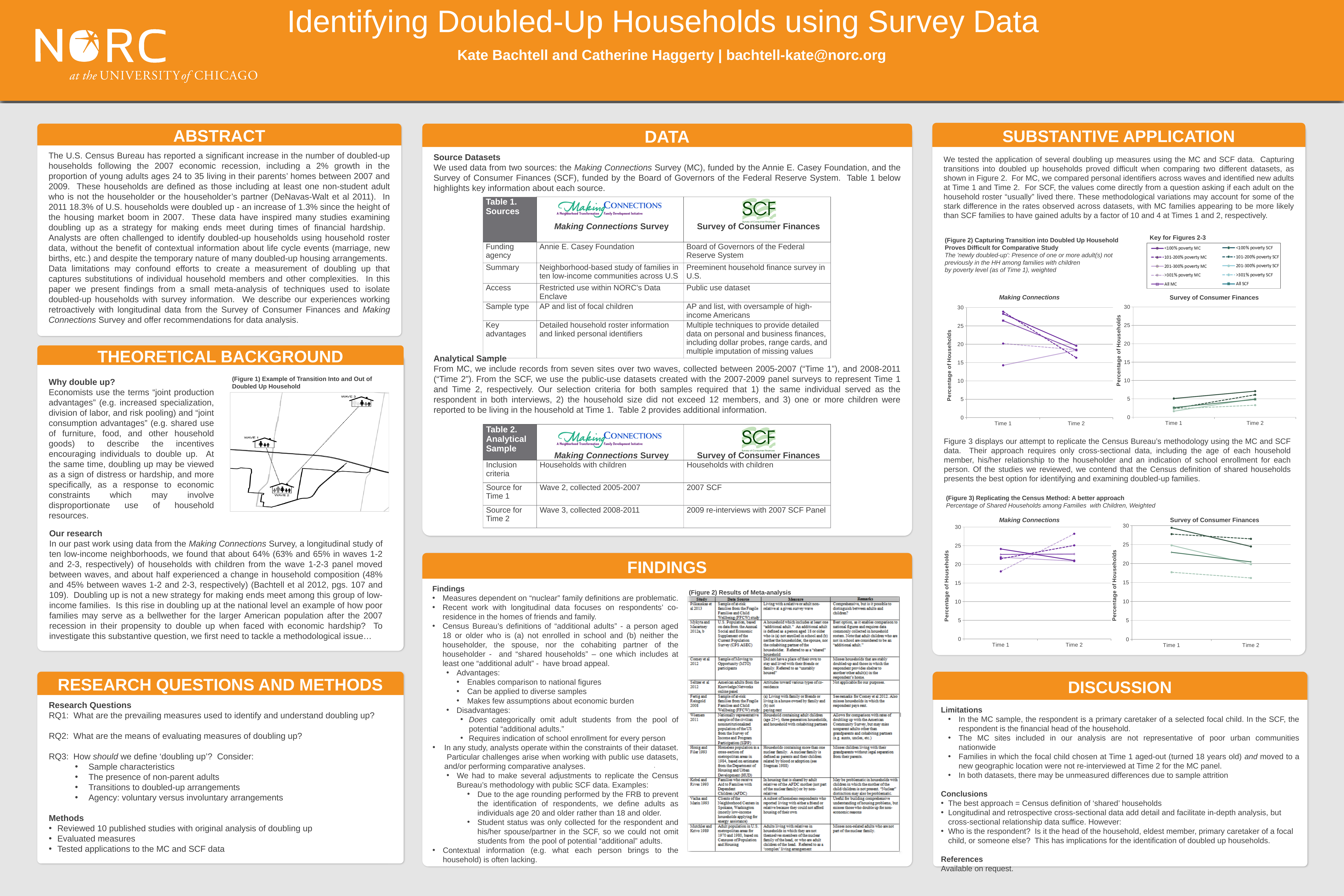
In the Figure 2 Survey of Consumer Finances chart, are all the values at Time 2 greater or less than 10? less How many time points are shown on the x axis of the Figure 3 Survey of Consumer Finances chart? 2 How many series in total does the Key for Figures 2-3 list? 10 In the Figure 2 Survey of Consumer Finances chart, do the lines rise or fall from Time 1 to Time 2? rise In the Figure 2 Making Connections chart, is the highest value at Time 1 greater or less than 25? greater What kind of chart is the Figure 2 Making Connections chart? line chart In the Figure 3 Survey of Consumer Finances chart, do the lines rise or fall from Time 1 to Time 2? fall In Figure 2, which chart shows higher percentages at Time 1, Making Connections or Survey of Consumer Finances? Making Connections How many Making Connections (MC) series does the Key for Figures 2-3 list? 5 What is the y-axis label on the Figure 3 Making Connections chart? Percentage of Households In the Figure 3 Making Connections chart, is the lowest value at Time 1 greater or less than 15? greater